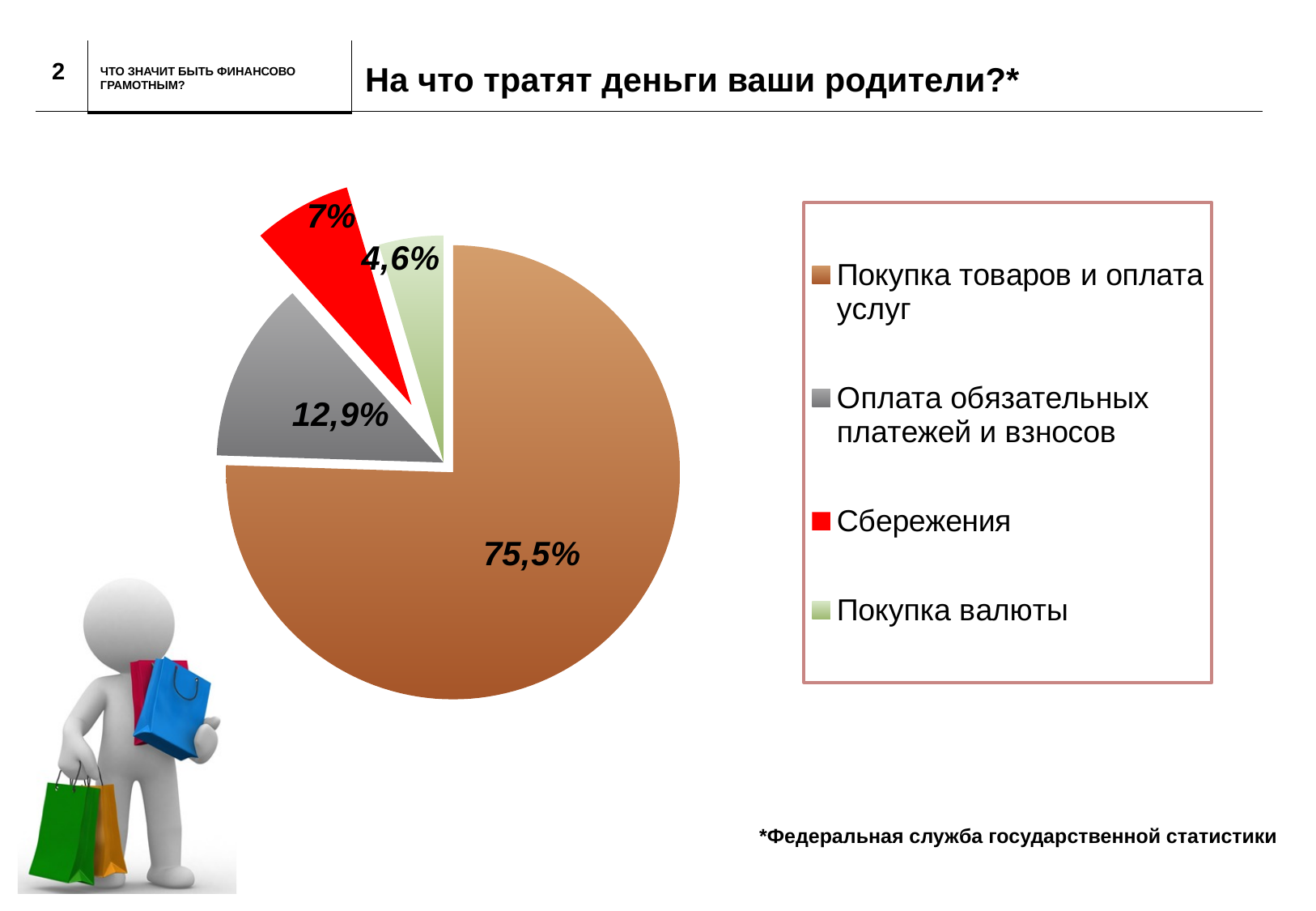
What is the difference between the shares for Оплата обязательных платежей и взносов and Сбережения? 5,9% What is the title of the chart on the slide? На что тратят деньги ваши родители?* What kind of chart is shown on the slide? pie chart Which category has the smallest slice of the pie? Покупка валюты What share of the pie is labelled for Оплата обязательных платежей и взносов? 12,9% Which is larger: the slice for Сбережения or the slice for Покупка валюты? Сбережения Which category has the largest slice of the pie? Покупка товаров и оплата услуг What share of the pie is labelled for Сбережения? 7% What colour is the slice for Сбережения? red What share of the pie is labelled for Покупка товаров и оплата услуг? 75,5% What share of the pie is labelled for Покупка валюты? 4,6% How many slices does the pie chart have? 4